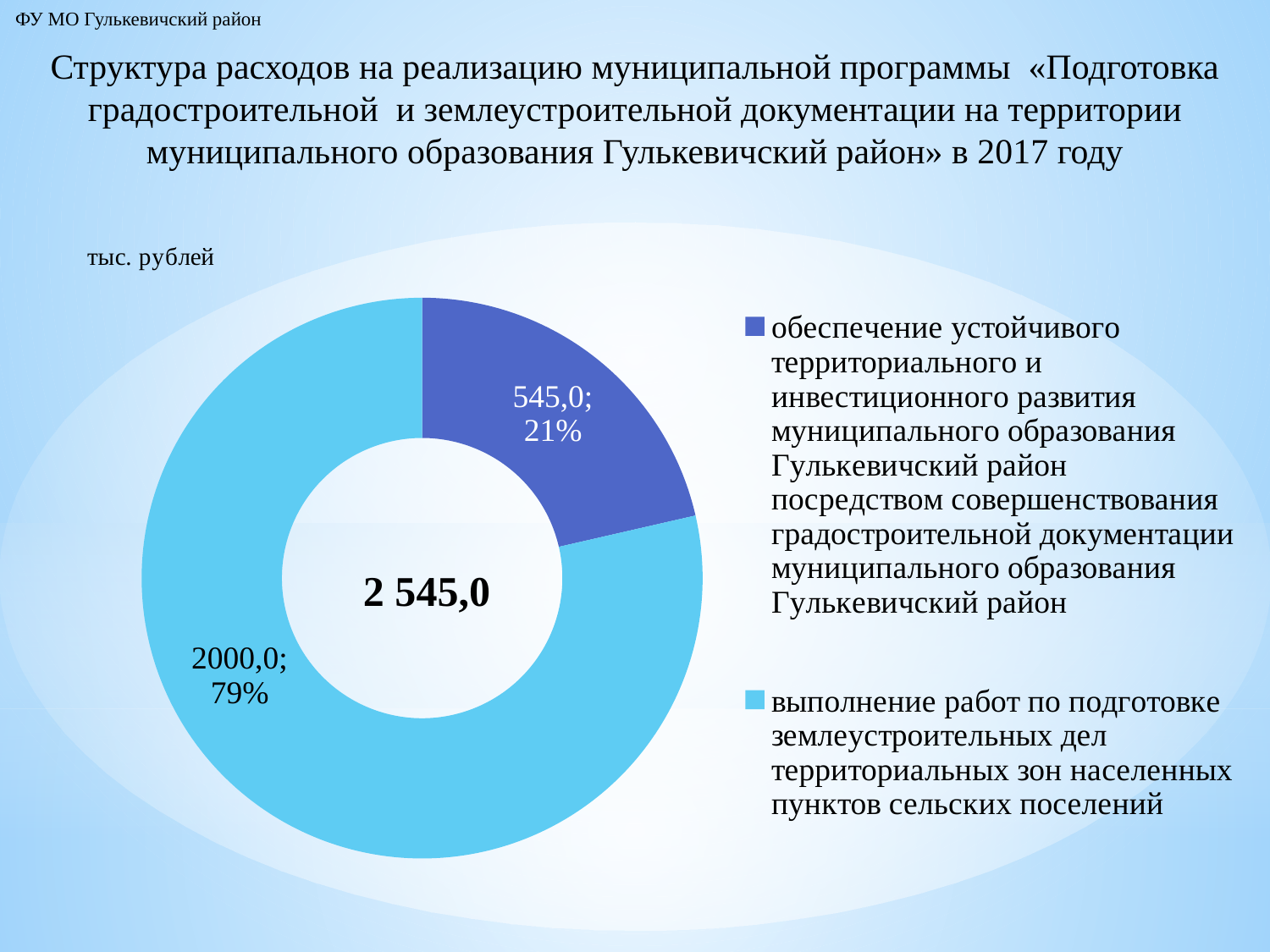
What is the value for the segment 'выполнение работ по подготовке землеустроительных дел территориальных зон населенных пунктов сельских поселений'? 2000,0 What share of the chart does the segment 'выполнение работ по подготовке землеустроительных дел' take? 79% Which segment is the largest? выполнение работ по подготовке землеустроительных дел территориальных зон населенных пунктов сельских поселений Which is larger: the segment for 'выполнение работ по подготовке землеустроительных дел' or the segment for 'обеспечение устойчивого территориального и инвестиционного развития'? выполнение работ по подготовке землеустроительных дел In what units are the chart values given, according to the label above the chart? тыс. рублей What is the difference between the two segment values, 2000,0 and 545,0? 1455,0 How many segments does the chart have? 2 What share of the chart does the segment 'обеспечение устойчивого территориального и инвестиционного развития' take? 21% Which segment is the smallest? обеспечение устойчивого территориального и инвестиционного развития муниципального образования Гулькевичский район What is the value for the segment 'обеспечение устойчивого территориального и инвестиционного развития муниципального образования Гулькевичский район...'? 545,0 What kind of chart is shown on the slide? Doughnut (pie) chart What total value is shown in the centre of the chart? 2 545,0